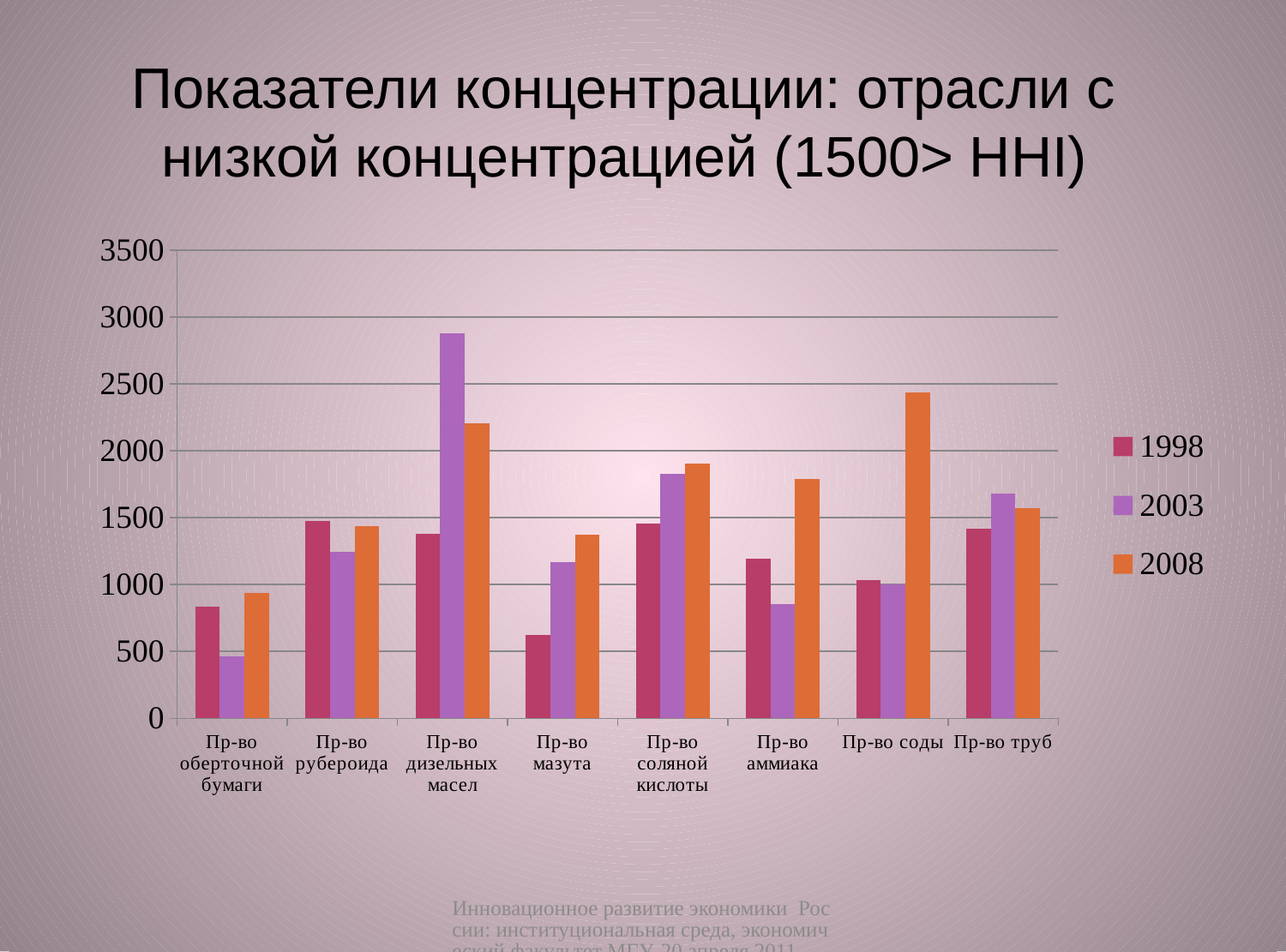
What kind of chart is shown on the slide? bar chart Which category has the lowest value for 1998? Пр-во мазута Is the 2003 value for Пр-во дизельных масел greater or less than 2500? greater How many categories are shown on the x axis? 8 How many series does the legend list? 3 Which category has the lowest value for 2003? Пр-во оберточной бумаги Which category has the highest value for 2008? Пр-во соды Which category has the highest value for 2003? Пр-во дизельных масел Is the 2008 value for Пр-во соды greater or less than 2000? greater For Пр-во мазута, do the values rise or fall from 1998 to 2003 to 2008? rise Which years are listed in the chart legend? 1998, 2003, 2008 For Пр-во мазута, which is larger: the 1998 value or the 2008 value? 2008